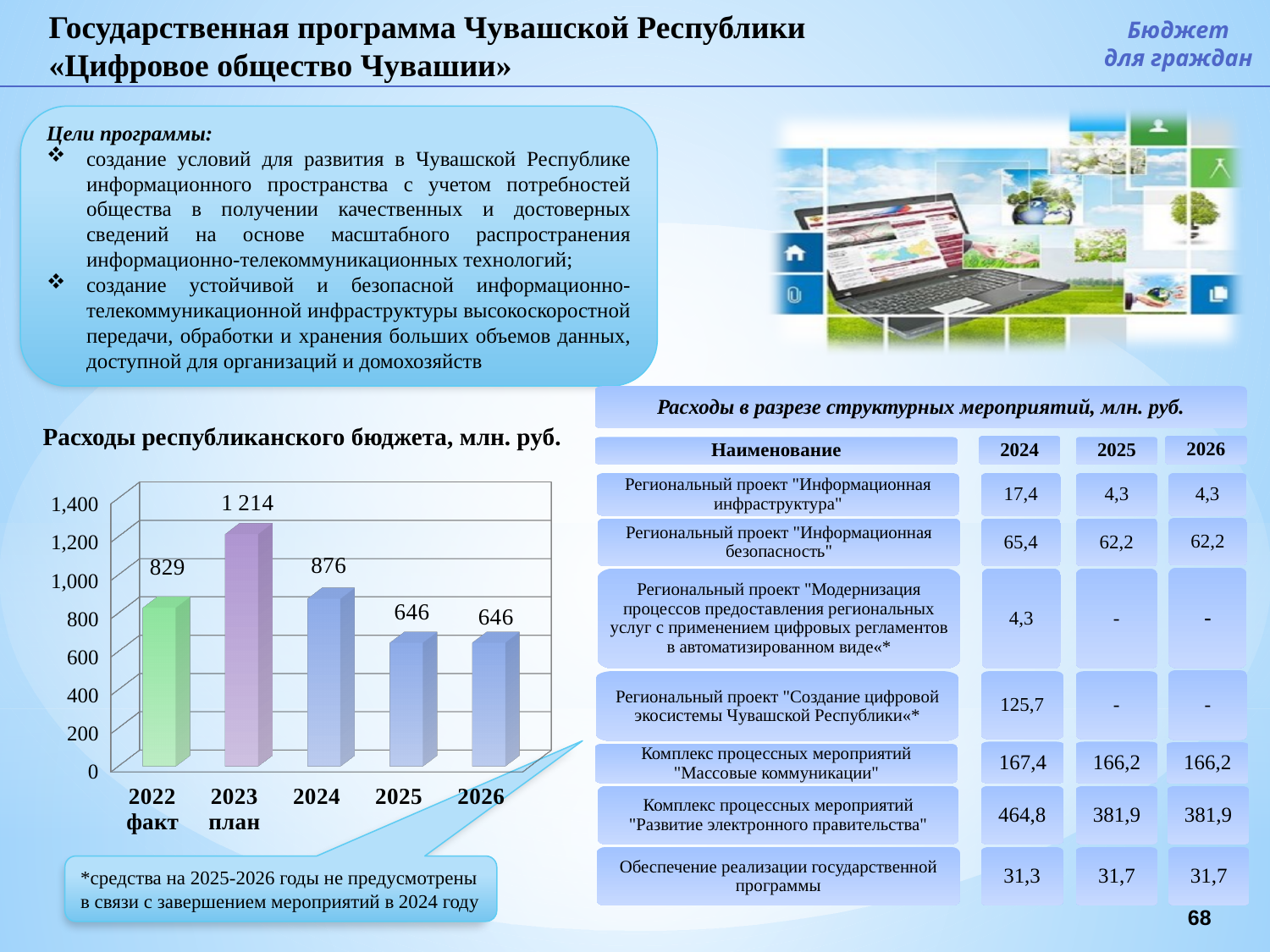
What is the title of the bar chart on the slide? Расходы республиканского бюджета, млн. руб. How many years are shown in the chart 'Расходы республиканского бюджета, млн. руб.'? 5 Which year has the highest value in the chart 'Расходы республиканского бюджета, млн. руб.'? 2023 What is the difference between the values for 2023 and 2024 in the chart 'Расходы республиканского бюджета, млн. руб.'? 338 What kind of chart is 'Расходы республиканского бюджета, млн. руб.'? bar chart What is the value for 2022 in the chart 'Расходы республиканского бюджета, млн. руб.'? 829 Is the value for 2024 in the chart 'Расходы республиканского бюджета, млн. руб.' greater or less than 1,000? less What is the value for 2023 in the chart 'Расходы республиканского бюджета, млн. руб.'? 1 214 Do the values in the chart 'Расходы республиканского бюджета, млн. руб.' rise or fall from 2023 to 2025? fall Which is larger in the chart 'Расходы республиканского бюджета, млн. руб.': the value for 2022 or the value for 2024? 2024 What is the value for 2025 in the chart 'Расходы республиканского бюджета, млн. руб.'? 646 What is the difference between the values for 2024 and 2022 in the chart 'Расходы республиканского бюджета, млн. руб.'? 47